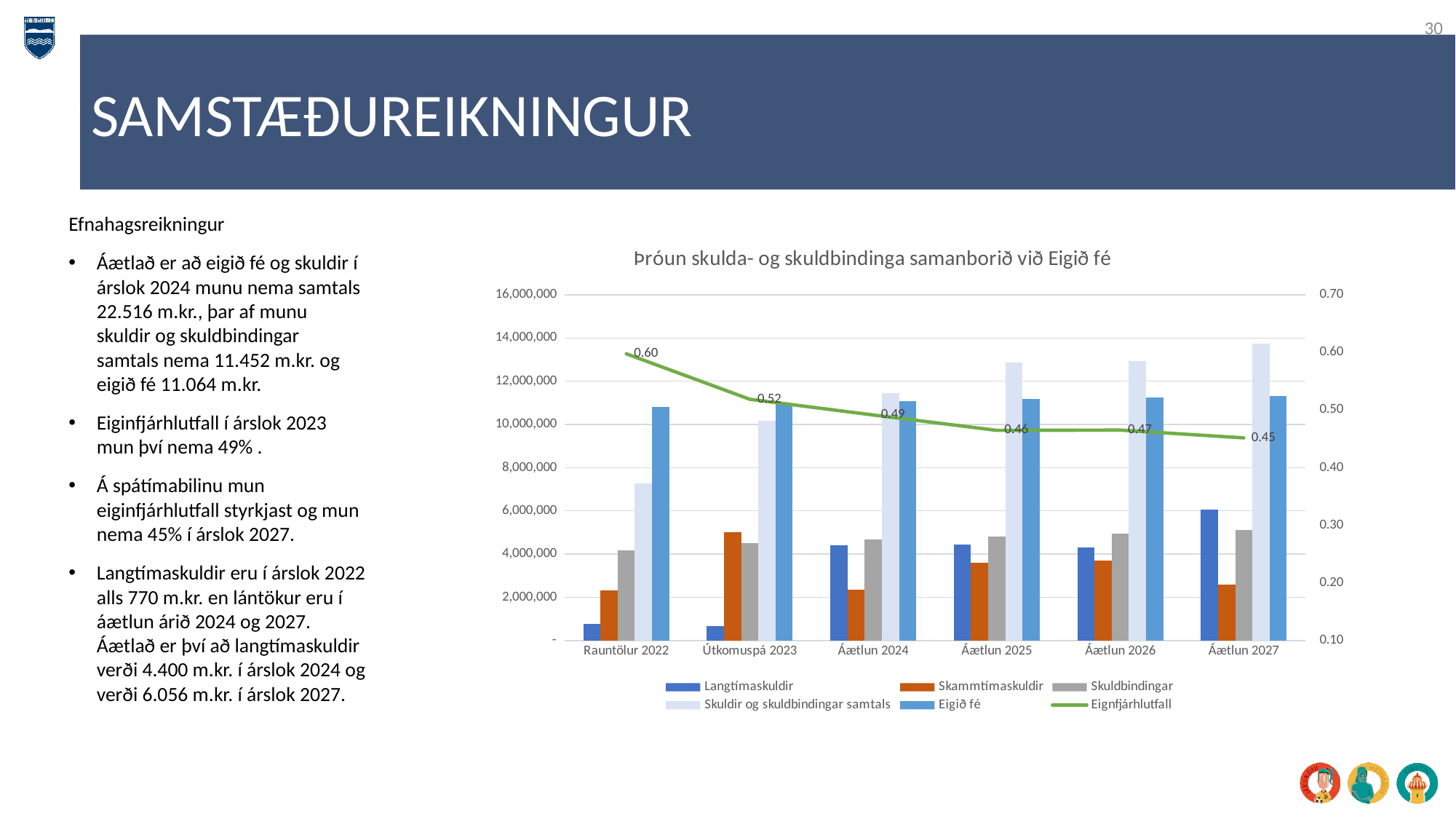
What is the Eignfjárhlutfall value for Áætlun 2027? 0.45 How many categories are shown on the x axis of the chart? 6 What is the difference between the Eignfjárhlutfall values for Rauntölur 2022 and Áætlun 2027? 0.15 Which has the larger Eignfjárhlutfall value, Áætlun 2025 or Áætlun 2026? Áætlun 2026 Which category has the lowest Eignfjárhlutfall value? Áætlun 2027 Is the value of Skuldir og skuldbindingar samtals for Áætlun 2027 greater or less than 12,000,000? greater Does the Eignfjárhlutfall line generally rise or fall from Rauntölur 2022 to Áætlun 2027? fall How many series does the chart legend list? 6 Is the value of Langtímaskuldir for Rauntölur 2022 greater or less than 2,000,000? less Which category has the highest Eignfjárhlutfall value? Rauntölur 2022 What is the Eignfjárhlutfall value for Áætlun 2024? 0.49 What is the Eignfjárhlutfall value for Rauntölur 2022? 0.60